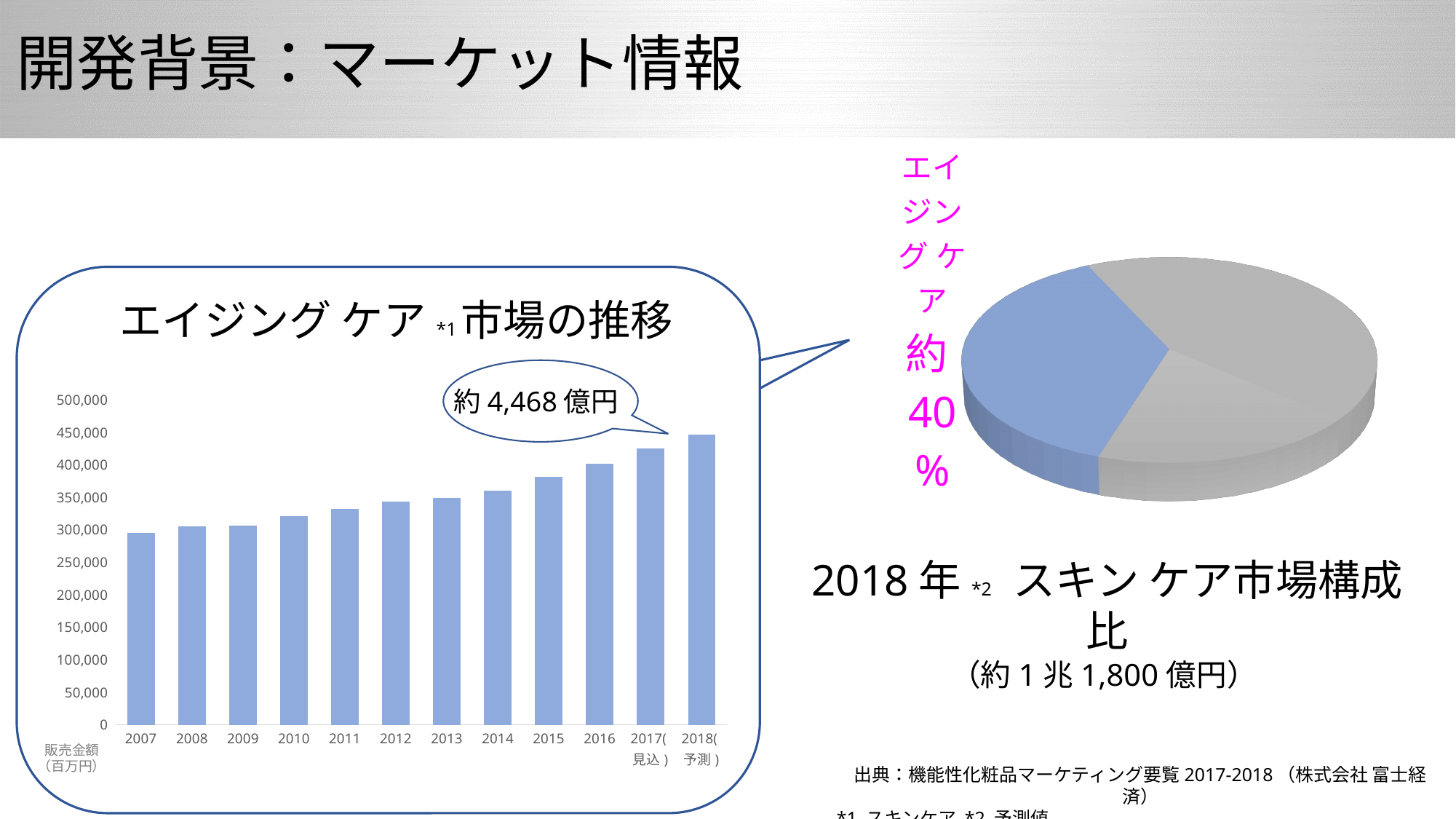
In the pie chart 2018年 スキンケア市場構成比, what share is labelled for エイジングケア? 約40% In the bar chart エイジングケア市場の推移, what is the label on the vertical axis? 販売金額（百万円） In the bar chart エイジングケア市場の推移, how many years (categories) are plotted on the x axis? 12 In the bar chart エイジングケア市場の推移, is the value for 2007 greater or less than 350,000? less What kind of chart is the right chart titled 2018年 スキンケア市場構成比? pie chart In the bar chart エイジングケア市場の推移, do the values rise or fall from 2007 to 2018? rise In the bar chart エイジングケア市場の推移, which year has the lowest bar? 2007 What kind of chart is the left chart titled エイジングケア市場の推移? bar chart In the bar chart エイジングケア市場の推移, is the value for 2015 greater or less than 350,000? greater In the bar chart エイジングケア市場の推移, which year has the highest bar? 2018(予測) In the bar chart エイジングケア市場の推移, is the value for 2018(予測) greater or less than 400,000? greater In the bar chart エイジングケア市場の推移, which is larger, the value for 2010 or the value for 2016? 2016